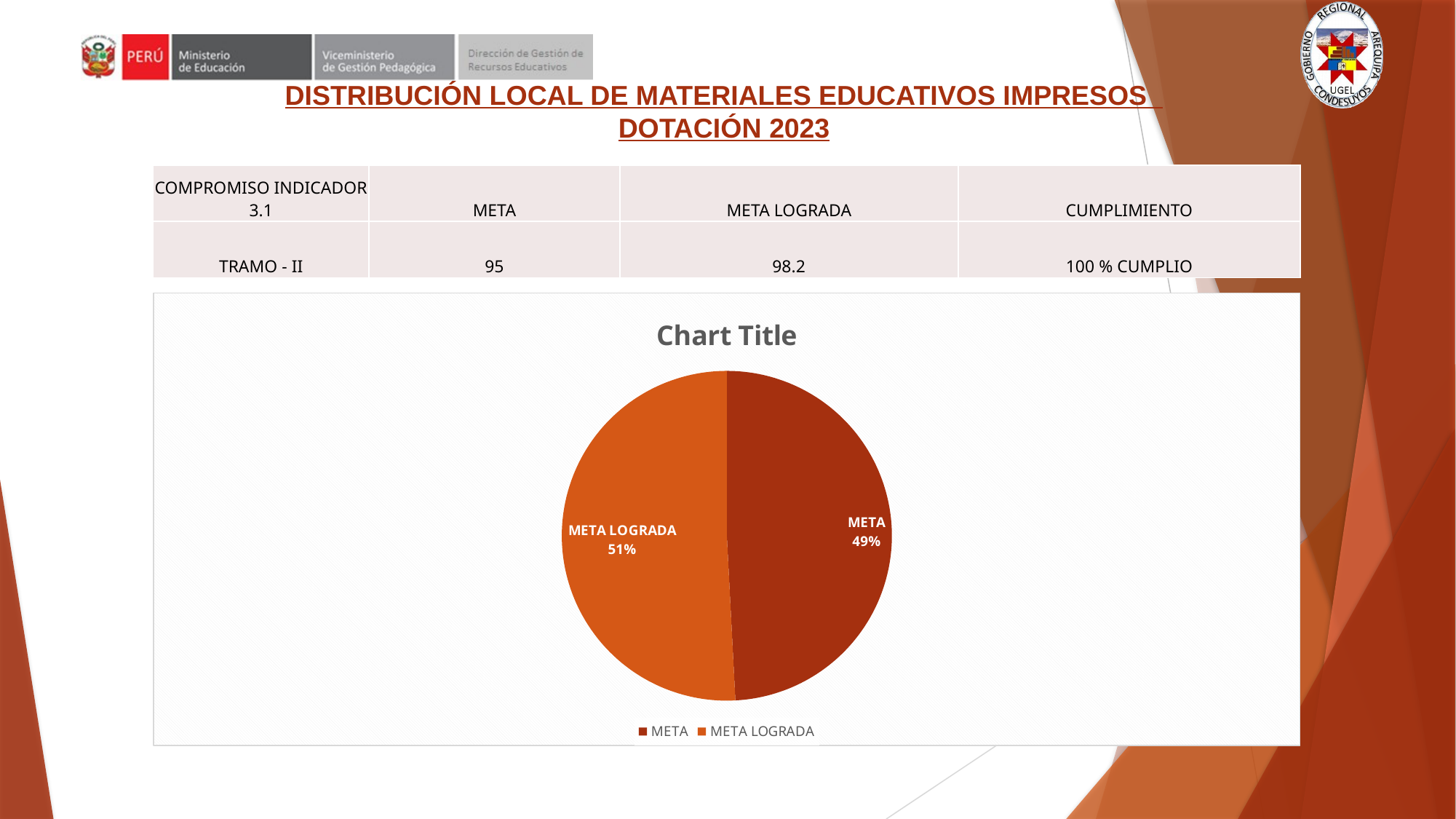
What share of the pie does META LOGRADA represent? 51% Which slice of the pie is the smallest? META What is the difference in percentage points between the META LOGRADA share and the META share? 2 percentage points What kind of chart is shown on the slide? pie chart How many slices does the pie chart have? 2 Which legend entry is shown in the darker red colour? META What share of the pie does META represent? 49% How many entries does the legend list? 2 Which slice of the pie is the largest? META LOGRADA Which is larger, the META LOGRADA share or the META share? META LOGRADA What is the title shown on the chart? Chart Title